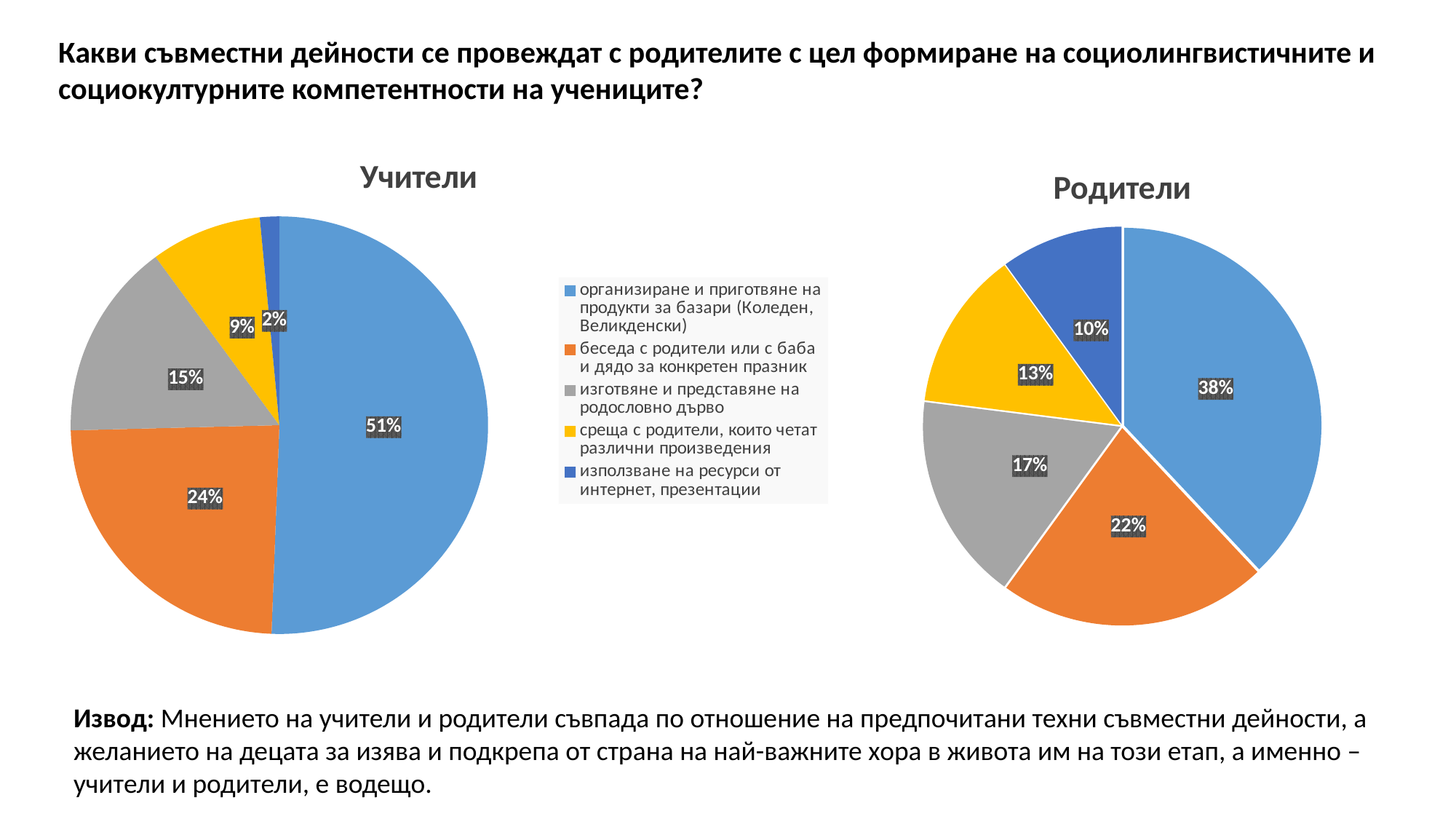
How many categories does the legend list? 5 In the "Родители" chart, what share is shown for "среща с родители, които четат различни произведения"? 13% In the "Учители" chart, what share is shown for "организиране и приготвяне на продукти за базари (Коледен, Великденски)"? 51% In the "Учители" chart, what is the difference between the largest slice and the second-largest slice? 27% In the "Родители" chart, which category has the smallest slice? използване на ресурси от интернет, презентации In the "Учители" chart, what share is shown for "използване на ресурси от интернет, презентации"? 2% In the "Родители" chart, what share is shown for "беседа с родители или с баба и дядо за конкретен празник"? 22% What is the difference between the "Учители" share and the "Родители" share for "изготвяне и представяне на родословно дърво"? 2% What colour represents "изготвяне и представяне на родословно дърво" in the charts? grey In the "Учители" chart, which category has the largest slice? организиране и приготвяне на продукти за базари (Коледен, Великденски) What type of chart is the "Родители" chart? pie chart Which chart shows a larger share for "използване на ресурси от интернет, презентации", "Учители" or "Родители"? Родители